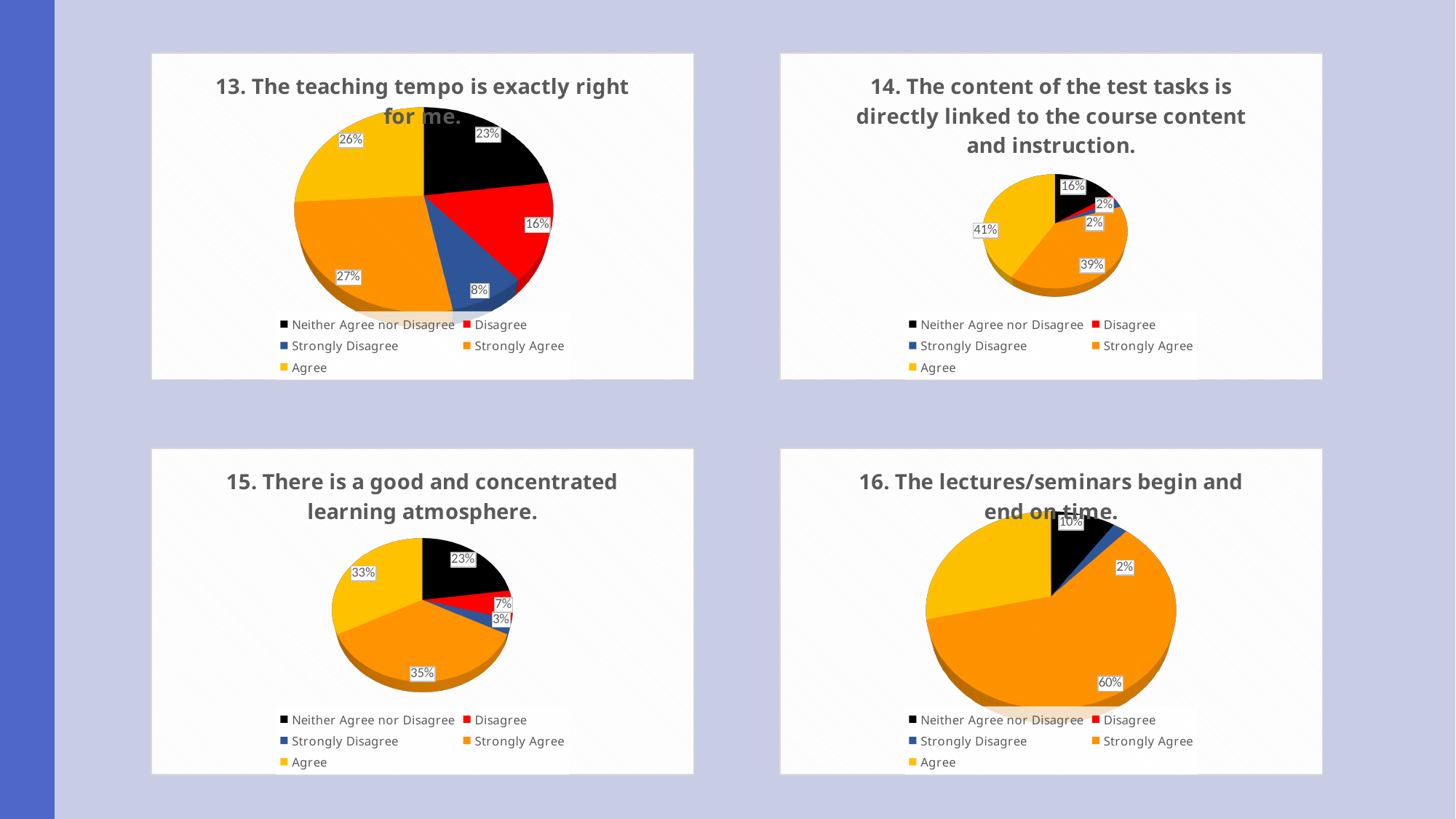
How many response categories does the legend of the chart titled "14. The content of the test tasks is directly linked to the course content and instruction." list? 5 In the chart titled "14. The content of the test tasks is directly linked to the course content and instruction.", what share of responses is Neither Agree nor Disagree? 16% In the chart titled "15. There is a good and concentrated learning atmosphere.", which response category has the largest share? Strongly Agree In the chart titled "13. The teaching tempo is exactly right for me.", which response category has the smallest share? Strongly Disagree In the chart titled "14. The content of the test tasks is directly linked to the course content and instruction.", what share of responses is Agree? 41% In the chart titled "15. There is a good and concentrated learning atmosphere.", is the Neither Agree nor Disagree share larger or smaller than the Agree share? smaller What kind of chart is used for "13. The teaching tempo is exactly right for me."? pie chart In the chart titled "15. There is a good and concentrated learning atmosphere.", what share of responses is Disagree? 7% In the chart titled "13. The teaching tempo is exactly right for me.", what share of responses is Strongly Agree? 27% In the chart titled "13. The teaching tempo is exactly right for me.", what is the difference between the Disagree share and the Strongly Disagree share? 8% In the chart titled "16. The lectures/seminars begin and end on time.", what share of responses is Neither Agree nor Disagree? 10% In the chart titled "16. The lectures/seminars begin and end on time.", what share of responses is Strongly Agree? 60%